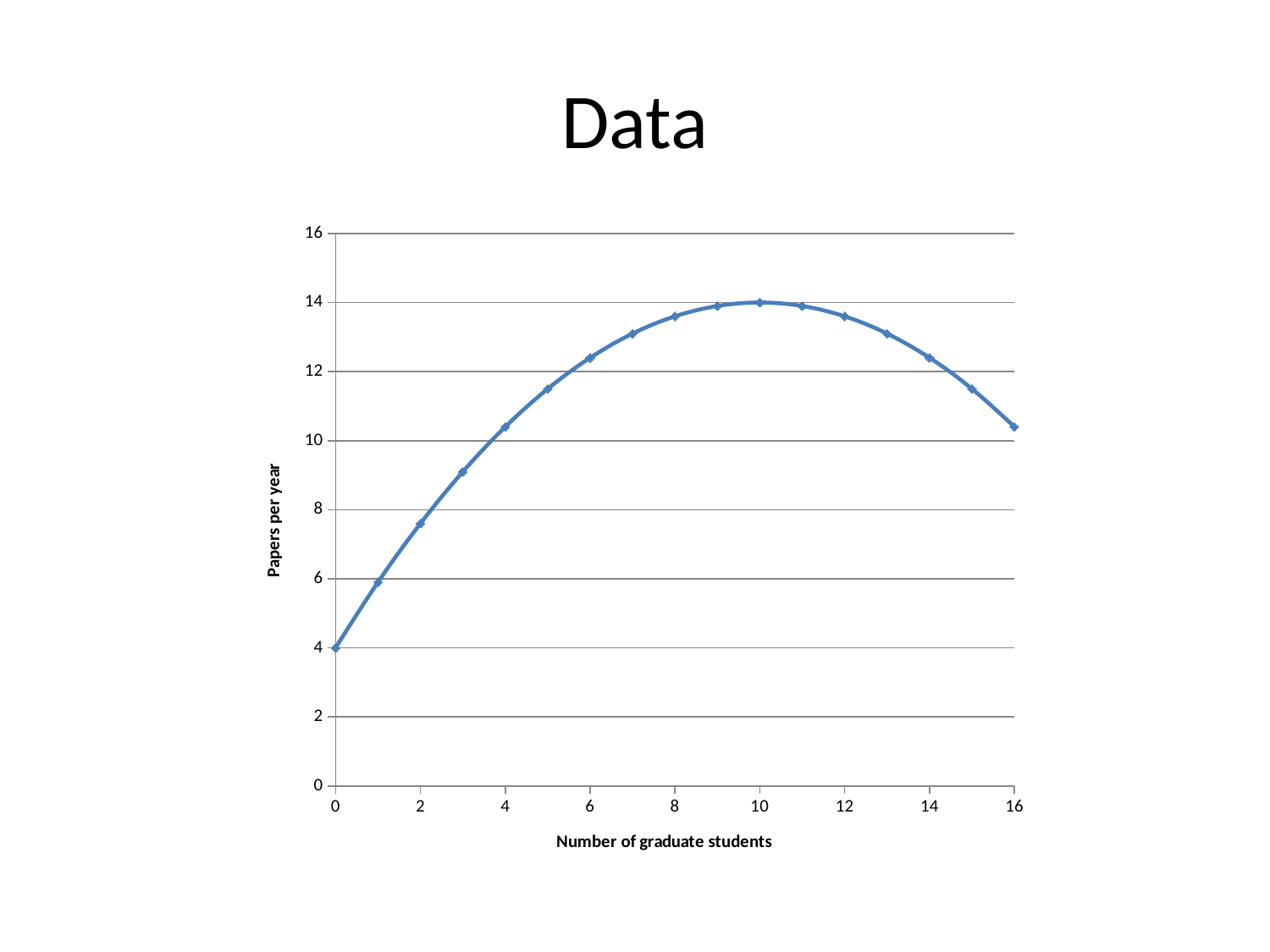
What is the value of papers per year when the number of graduate students is 0? 4 What is the label of the x axis? Number of graduate students What kind of chart is shown on the slide? line chart At which number of graduate students is papers per year highest? 10 How do papers per year change as the number of graduate students increases from 0 to 16? rise to a peak at 10, then fall Is the value for 16 graduate students greater or less than 12? less Is the value for 2 graduate students greater or less than 8? less At which number of graduate students is papers per year lowest? 0 Which has more papers per year: 2 graduate students or 14 graduate students? 14 graduate students What is the value of papers per year when the number of graduate students is 10? 14 How many data points are plotted on the chart? 17 Is the value for 6 graduate students greater or less than 12? greater